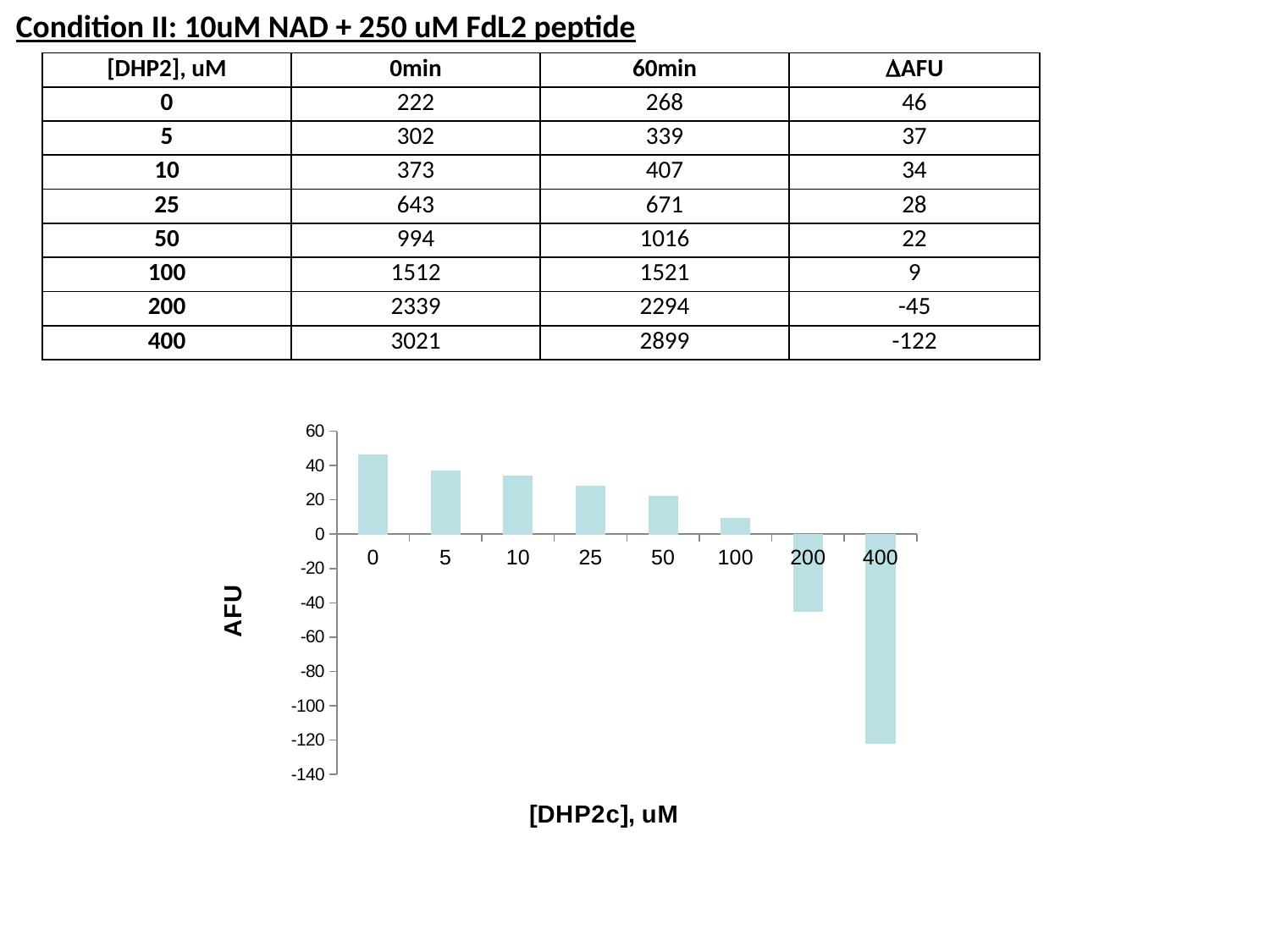
How many bars (concentration categories) does the chart show? 8 Which [DHP2c] concentration has the highest AFU value in the chart? 0 Which [DHP2c] concentration has the lowest AFU value in the chart? 400 Do the AFU values rise or fall as [DHP2c] increases along the x axis? fall Which has the larger AFU value, 5 uM or 50 uM? 5 uM Is the AFU value for 0 uM greater or less than 40? greater Is the AFU value for 200 uM greater or less than -40? less Is the AFU value for 100 uM greater or less than 20? less What is the label of the chart's y axis? AFU What is the label of the chart's x axis? [DHP2c], uM What kind of chart is shown on the slide? bar chart